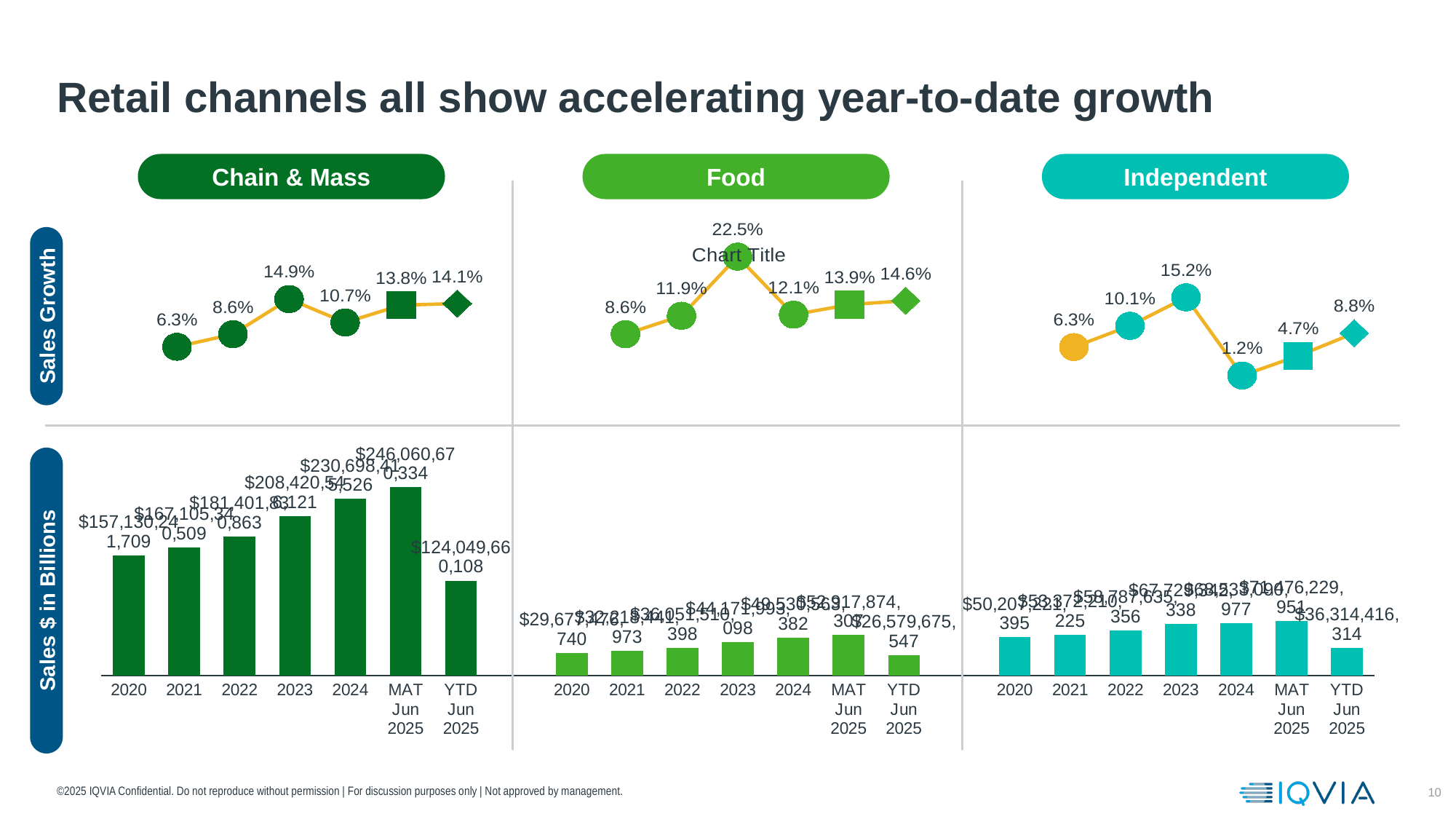
What kind of chart is used for the Sales $ in Billions row? Bar chart In the Independent Sales Growth chart, what is the difference between the highest value (15.2%) and the lowest value (1.2%)? 14.0% In the Independent Sales Growth chart, what is the lowest growth value shown? 1.2% In the Independent Sales Growth chart, which is larger: the square marker value or the diamond marker value? The diamond marker value (8.8%) In the Chain & Mass Sales Growth chart, what is the lowest growth value shown? 6.3% In the Food Sales Growth chart, what is the highest growth value shown? 22.5% How many bars are in the Chain & Mass Sales $ in Billions chart? 7 In the Chain & Mass Sales $ in Billions chart, do the values rise or fall from 2020 to 2024? Rise In the Chain & Mass Sales Growth chart, what is the highest growth value shown? 14.9% In the Food Sales Growth chart, what is the value of the last point (diamond marker)? 14.6% How many data points are plotted in the Food Sales Growth line chart? 6 In the Food Sales $ in Billions chart, which category has the shortest bar? YTD Jun 2025